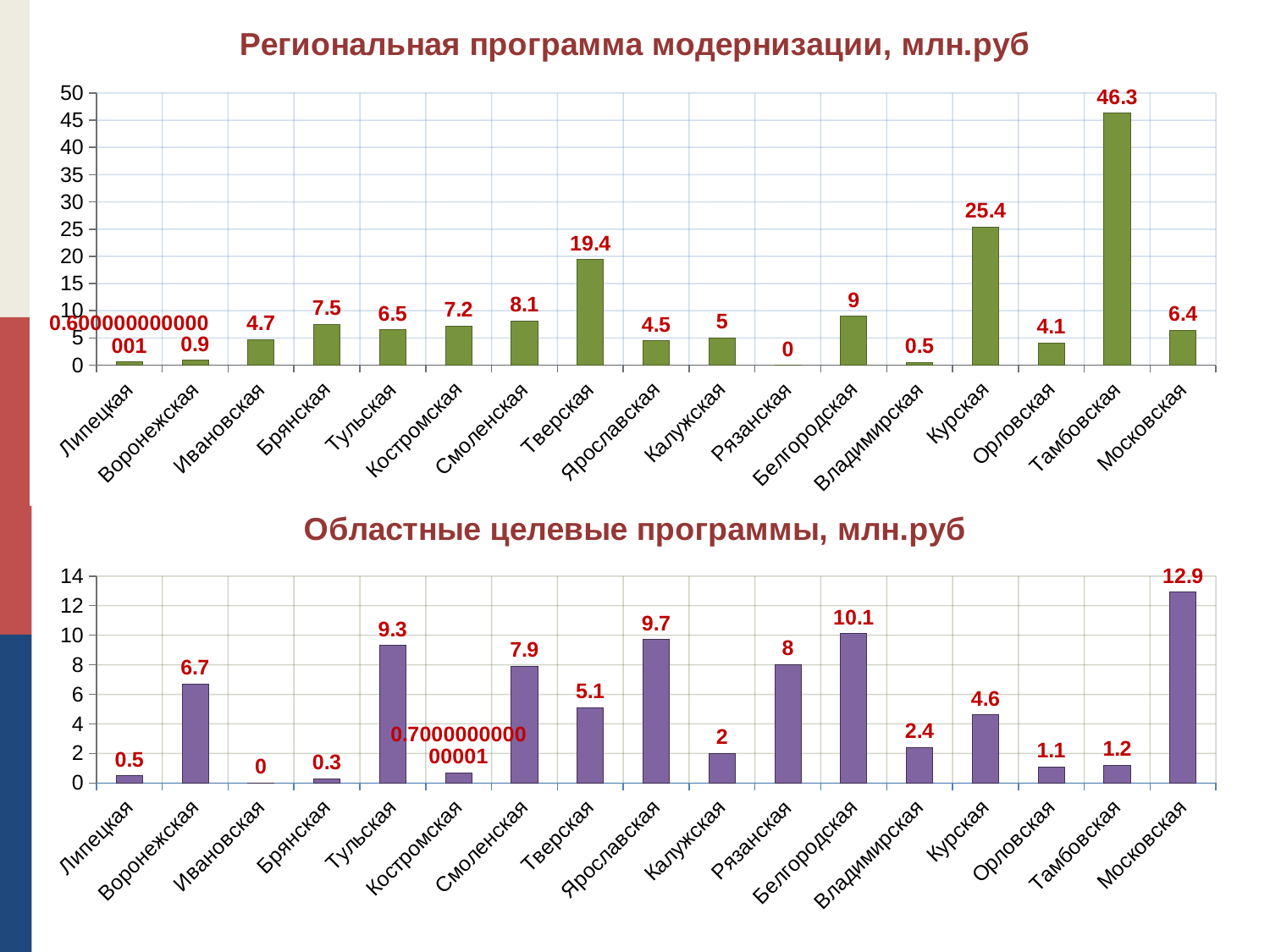
In the chart 'Региональная программа модернизации, млн.руб', what is the value for Тверская? 19.4 In the chart 'Региональная программа модернизации, млн.руб', how many regions are shown on the x axis? 17 In the chart 'Областные целевые программы, млн.руб', what is the value for Белгородская? 10.1 In the chart 'Региональная программа модернизации, млн.руб', which region has the highest value? Тамбовская In the chart 'Областные целевые программы, млн.руб', which region has the lowest value? Ивановская What type of chart is the bottom chart 'Областные целевые программы, млн.руб'? Bar chart In the chart 'Региональная программа модернизации, млн.руб', which region has the lowest value? Рязанская In the chart 'Областные целевые программы, млн.руб', is the value for Тульская greater or less than 8? greater In the chart 'Региональная программа модернизации, млн.руб', which is larger, the value for Брянская or the value for Тульская? Брянская In the chart 'Областные целевые программы, млн.руб', which region has the highest value? Московская In the chart 'Областные целевые программы, млн.руб', what is the difference between the values for Ярославская and Тверская? 4.6 In the chart 'Региональная программа модернизации, млн.руб', what is the difference between the values for Тамбовская and Курская? 20.9